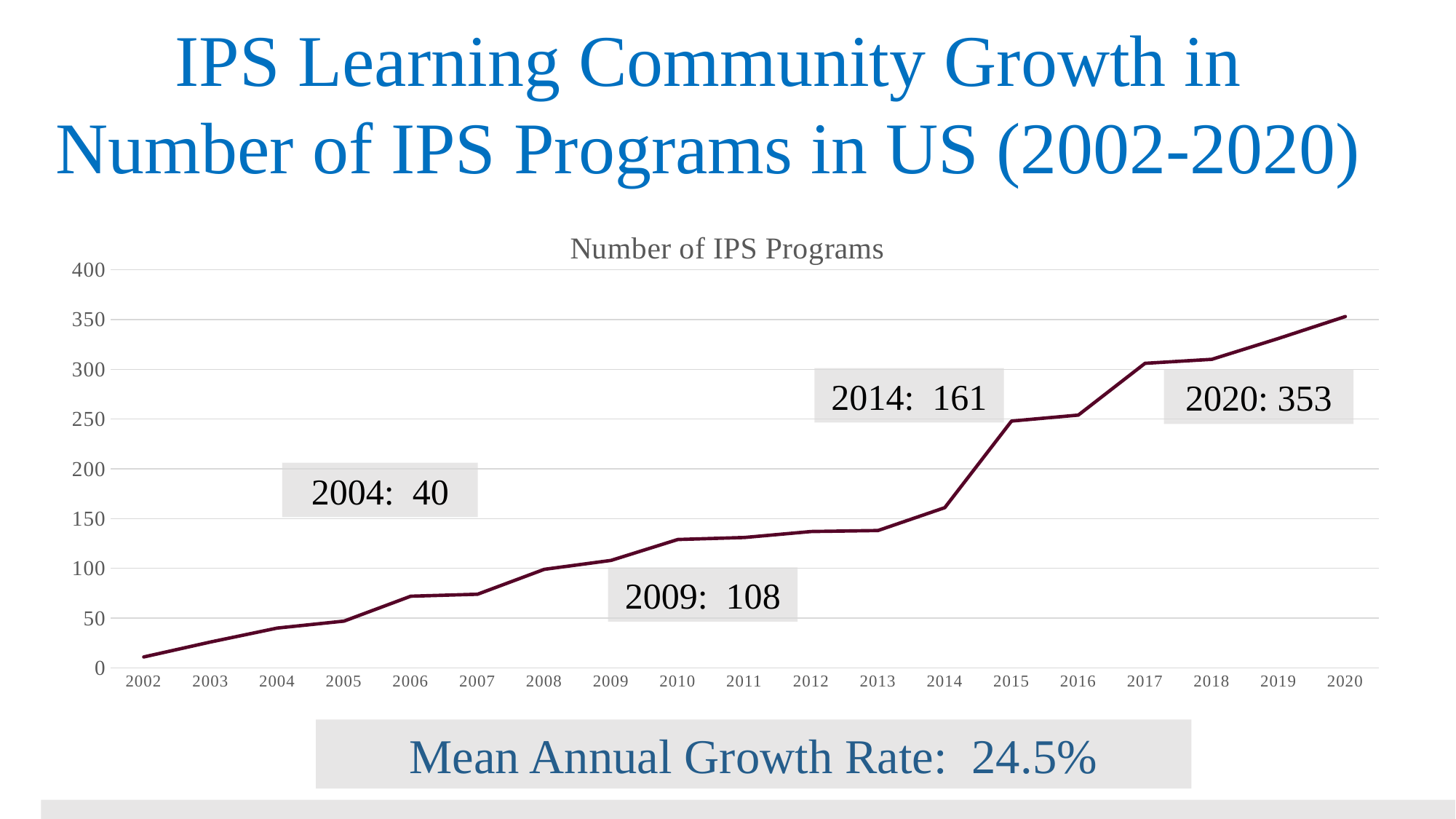
Does the number of IPS programs rise or fall from 2002 to 2020? rise What is the number of IPS programs in 2014? 161 What is the difference between the number of IPS programs in 2009 and in 2004? 68 Which year has the lowest number of IPS programs? 2002 What type of chart is shown on the slide? line chart What is the number of IPS programs in 2009? 108 What is the number of IPS programs in 2004? 40 What is the number of IPS programs in 2020? 353 Is the value for 2017 greater or less than 300? greater What is the difference between the number of IPS programs in 2020 and in 2014? 192 How many years are plotted on the x axis? 19 Which year has the highest number of IPS programs? 2020